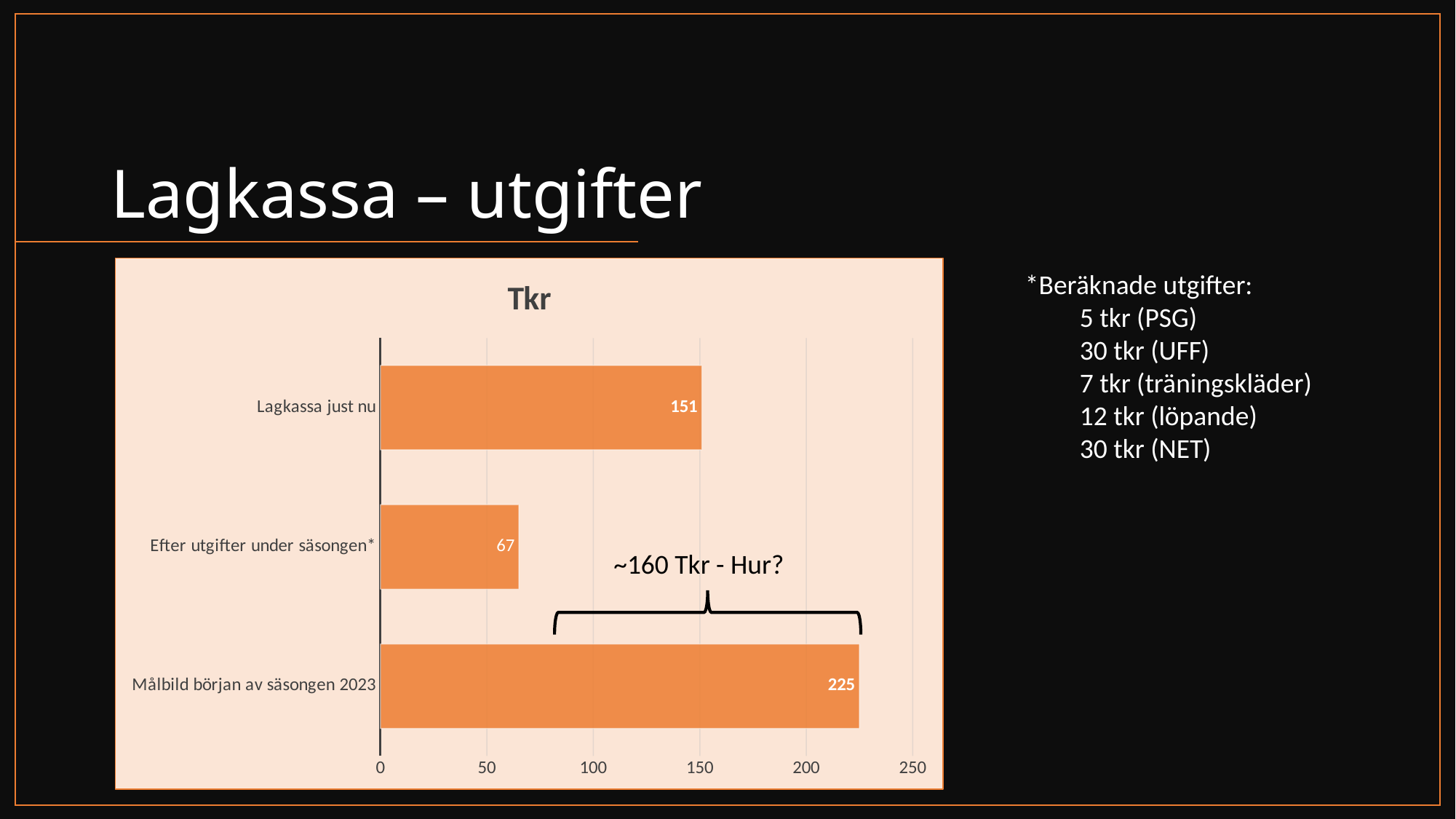
What kind of chart is shown on the slide? bar chart Which category has the lowest value? Efter utgifter under säsongen* What is the title of the chart? Tkr What is the difference between the values for "Lagkassa just nu" and "Efter utgifter under säsongen*"? 84 Which is larger, the value for "Lagkassa just nu" or the value for "Målbild början av säsongen 2023"? Målbild början av säsongen 2023 Is the value for "Efter utgifter under säsongen*" greater or less than 100? less What is the value for "Efter utgifter under säsongen*"? 67 What is the difference between the values for "Målbild början av säsongen 2023" and "Efter utgifter under säsongen*"? 158 How many categories are shown in the chart? 3 What is the value for "Lagkassa just nu"? 151 What is the value for "Målbild början av säsongen 2023"? 225 Which category has the highest value? Målbild början av säsongen 2023